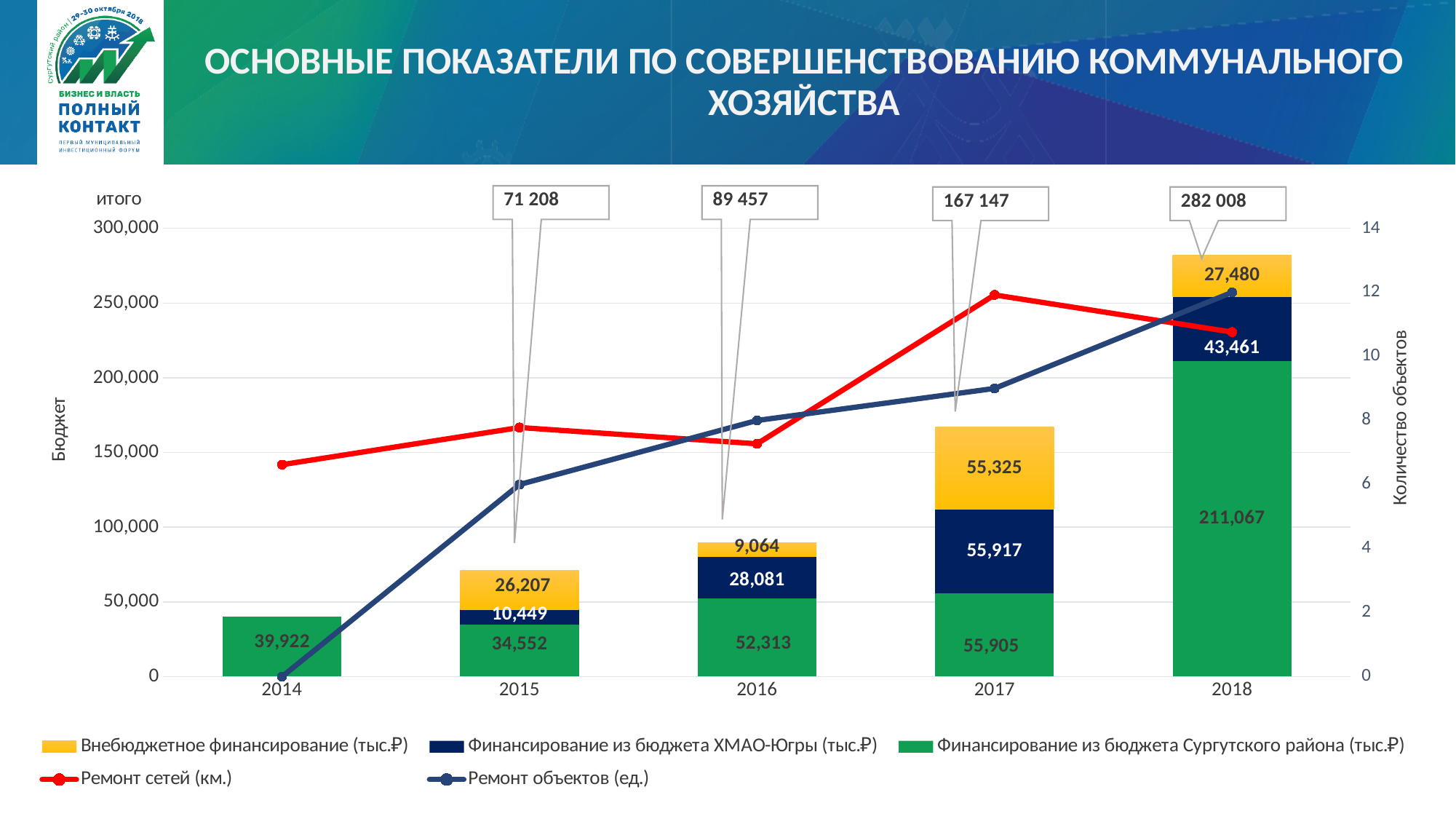
In 2015, which is larger: Внебюджетное финансирование or Финансирование из бюджета ХМАО-Югры? Внебюджетное финансирование What is the difference between Внебюджетное финансирование in 2018 and in 2016? 18,416 In which year is Финансирование из бюджета Сургутского района (тыс.₽) the highest? 2018 How many series does the legend list? 5 In which year is Финансирование из бюджета Сургутского района (тыс.₽) the lowest? 2015 What is the total (итого) of the stacked bar for 2018? 282 008 What is the value of Внебюджетное финансирование (тыс.₽) in 2017? 55,325 What is the value of Финансирование из бюджета Сургутского района (тыс.₽) in 2018? 211,067 What is the total (итого) of the stacked bar for 2017? 167 147 Is the value for Ремонт объектов (ед.) in 2018 greater or less than 10? greater Does Ремонт объектов (ед.) rise or fall from 2014 to 2018? rises What is the value of Финансирование из бюджета ХМАО-Югры (тыс.₽) in 2016? 28,081